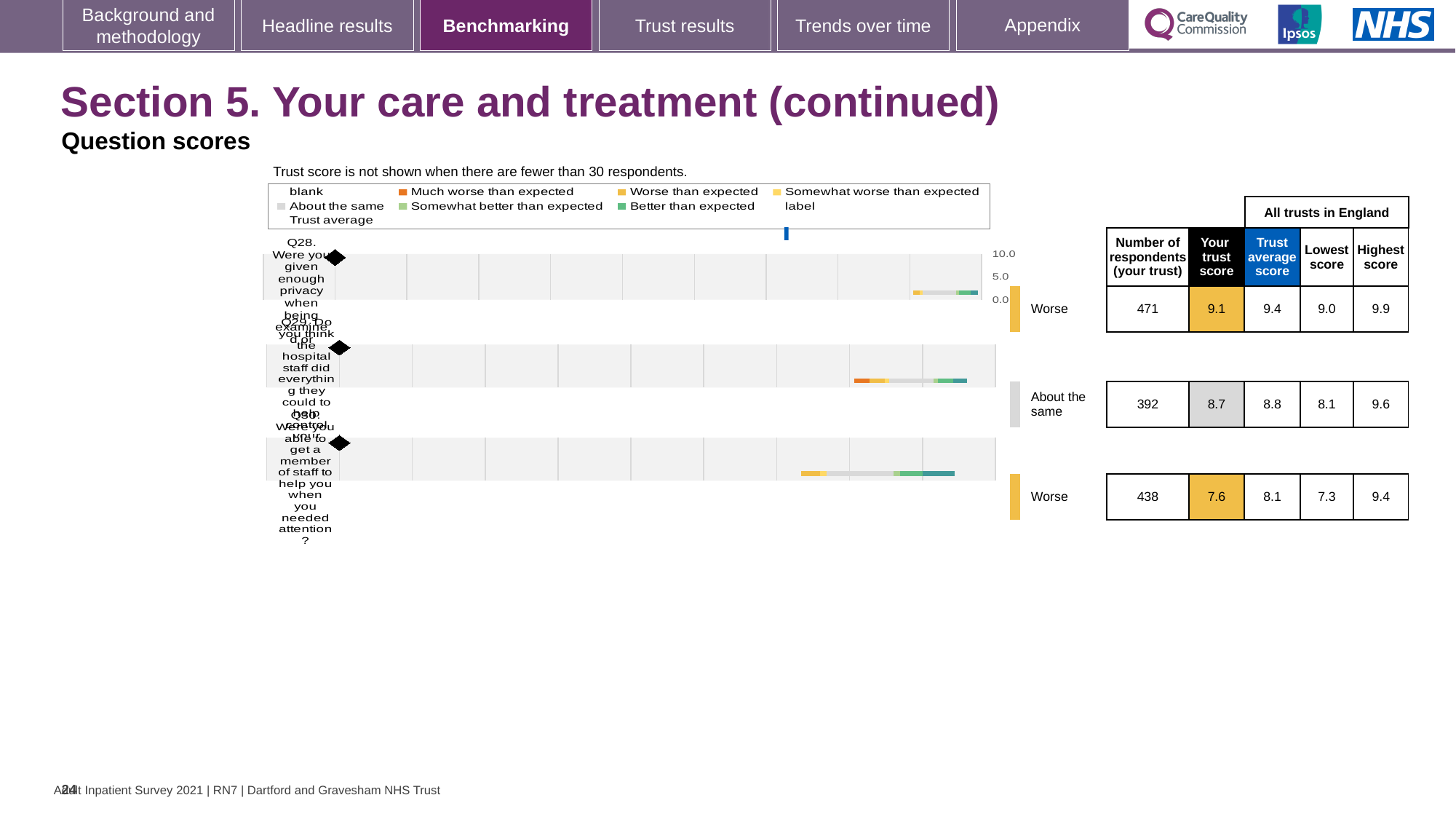
How many of the three questions are rated 'Worse' than expected? 2 What is the difference between the trust average score and your trust score for Q30? 0.5 What is the 'Your trust score' for Q28 (Were you given enough privacy when being examined or treated?)? 9.1 How many respondents from your trust answered Q30 (Were you able to get a member of staff to help you when you needed attention?)? 438 How many questions are shown in the benchmarking charts on this slide? 3 Which question has the lowest 'Your trust score' on this slide? Q30 What benchmark category is shown for Q29? About the same What kind of chart is used to show the question scores on this slide? Bar chart What is the trust average score for Q29 (Do you think the hospital staff did everything they could to help control your pain?)? 8.8 What is the lowest score across all trusts in England for Q30? 7.3 What is the highest score across all trusts in England for Q28? 9.9 Which has the higher 'Your trust score': Q28 or Q29? Q28